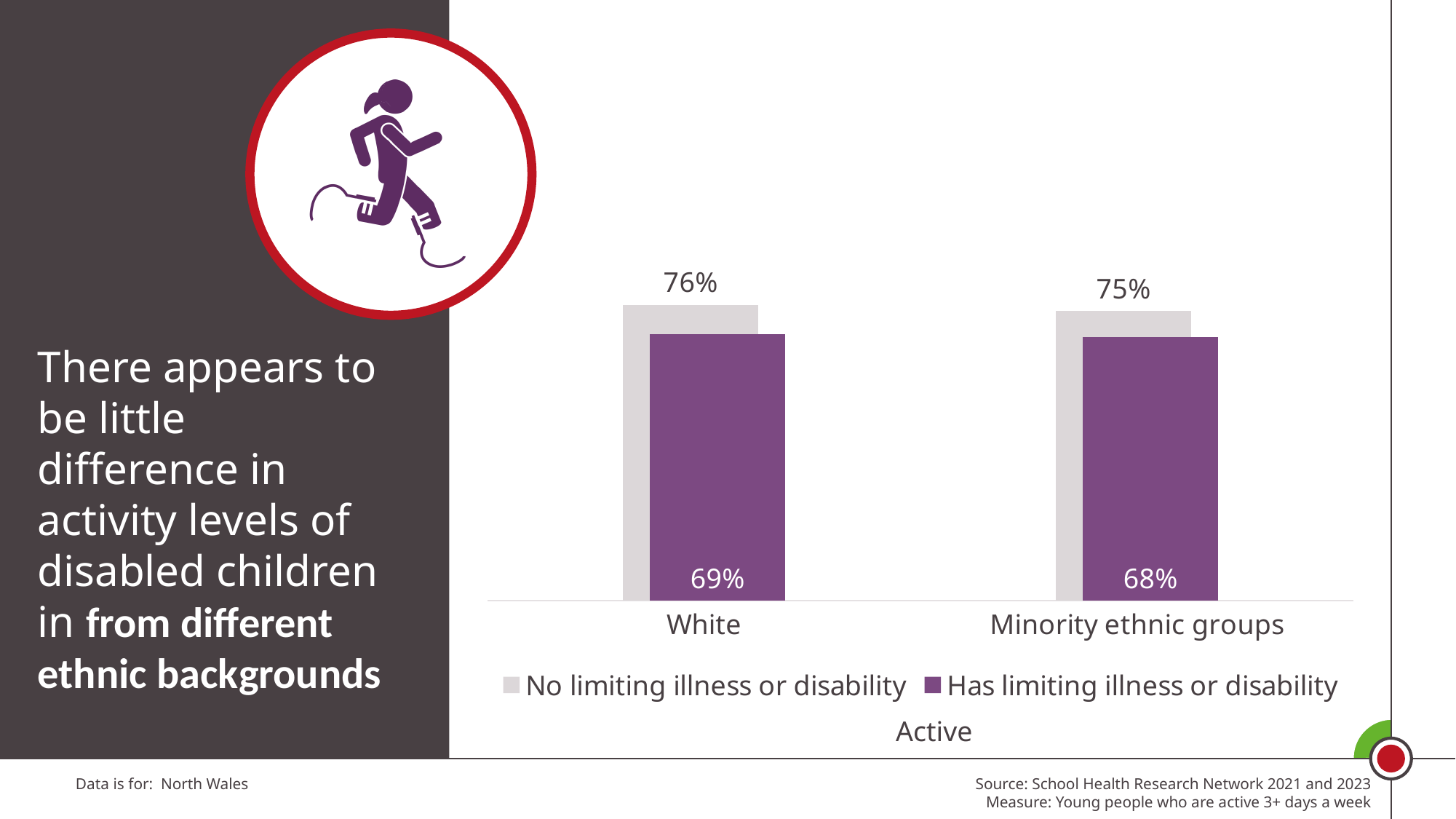
Which colour represents the 'Has limiting illness or disability' series? Purple What is the value for White in the 'No limiting illness or disability' series? 76% How many categories are shown on the x axis? 2 What is the difference between the 'No limiting illness or disability' and 'Has limiting illness or disability' values for White? 7 percentage points What is the value for Minority ethnic groups in the 'No limiting illness or disability' series? 75% Which is larger for White: the 'No limiting illness or disability' value or the 'Has limiting illness or disability' value? No limiting illness or disability How many series does the legend list? 2 What is the value for Minority ethnic groups in the 'Has limiting illness or disability' series? 68% What is the difference between the 'No limiting illness or disability' and 'Has limiting illness or disability' values for Minority ethnic groups? 7 percentage points What kind of chart is shown on the slide? Bar chart What is the title shown below the chart's legend? Active What is the value for White in the 'Has limiting illness or disability' series? 69%